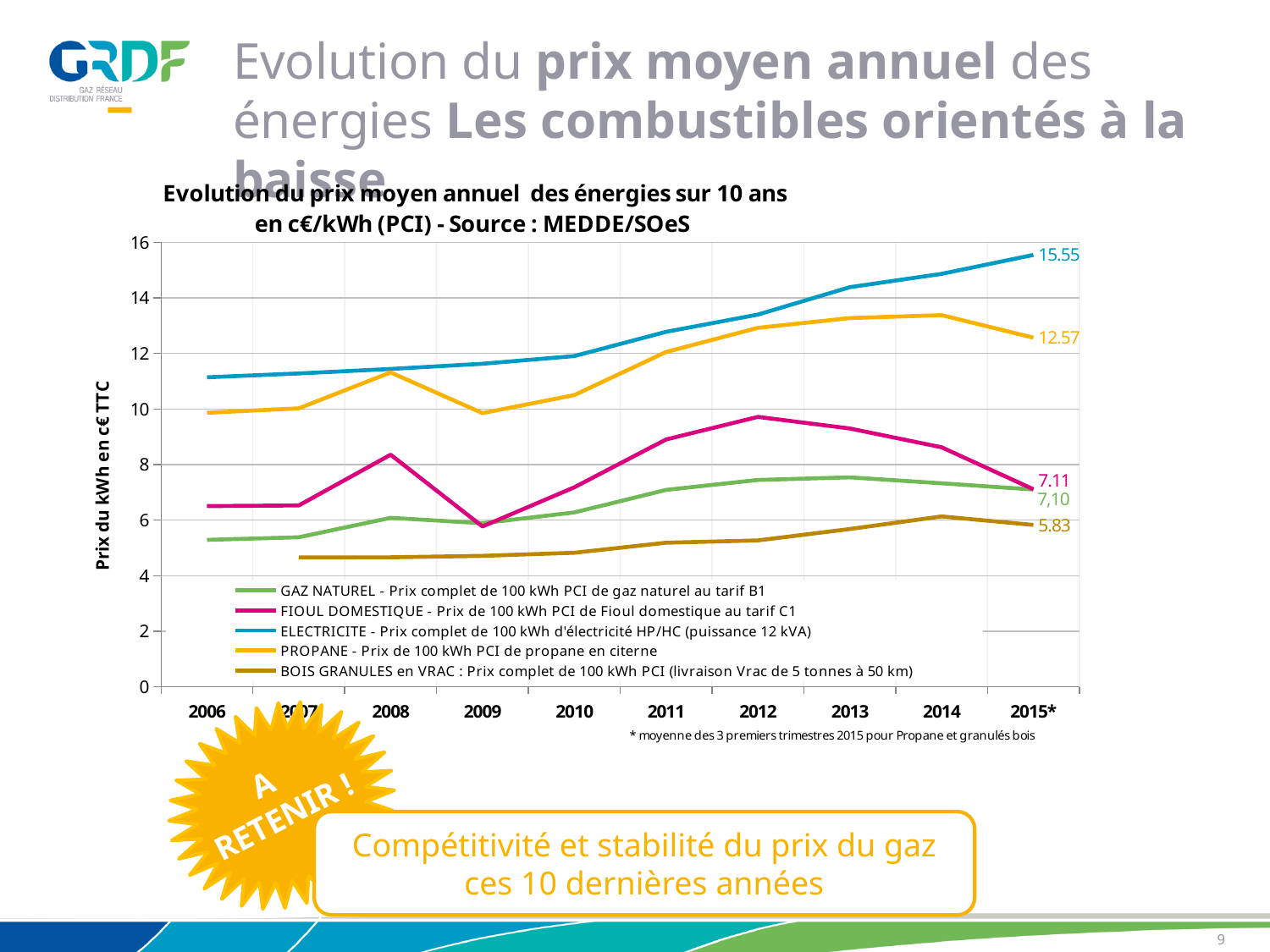
Which energy has the lowest value at 2015*? BOIS GRANULES en VRAC Which energy has the highest value at 2015*? ELECTRICITE What is the value labelled for PROPANE at 2015*? 12.57 What kind of chart is shown on the slide? line chart What is the label of the y axis of the chart? Prix du kWh en c€ TTC What is the value labelled for ELECTRICITE at 2015*? 15.55 How many series does the chart legend list? 5 Is the value for ELECTRICITE in 2006 greater or less than 10? greater What is the difference between the ELECTRICITE and PROPANE values at 2015*? 2.98 How many years are shown along the x axis of the chart? 10 Does the ELECTRICITE line rise or fall from 2006 to 2015*? rise What is the value labelled for BOIS GRANULES en VRAC at 2015*? 5.83